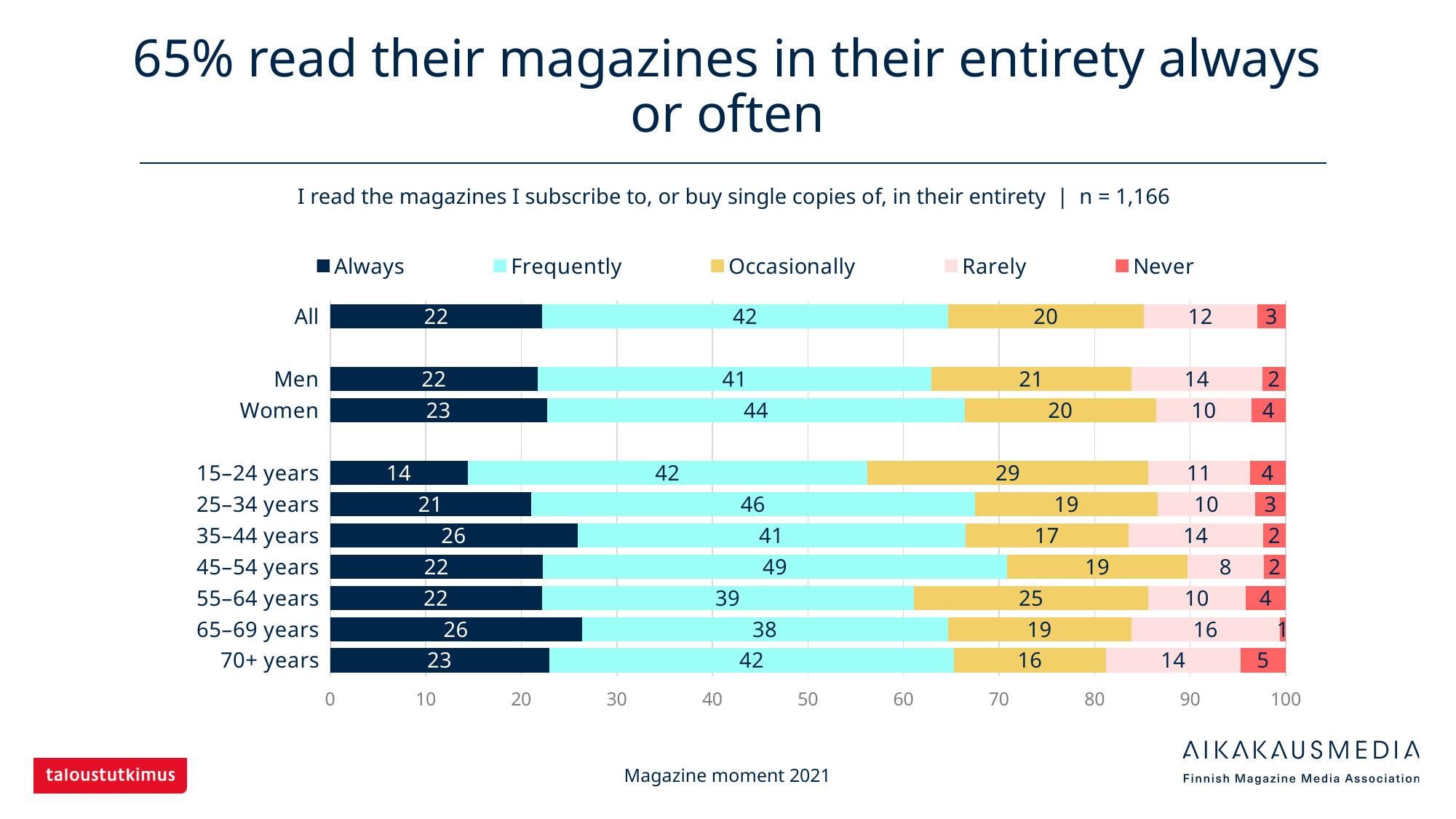
What is the difference between the Always value for 35–44 years and the Always value for 15–24 years? 12 What kind of chart is shown on the slide? Stacked bar chart Which category has the highest value for Frequently? 45–54 years What is the value for Frequently in the 45–54 years category? 49 Which category has the lowest value for Frequently? 65–69 years Which has a larger Rarely value, Men or Women? Men What is the total of the stacked bar for the All category? 99 What is the value for Never in the 70+ years category? 5 How many series does the legend list? 5 Which category has the lowest value for Always? 15–24 years What is the value for Occasionally in the 15–24 years category? 29 How many categories are shown on the y axis of the chart? 10